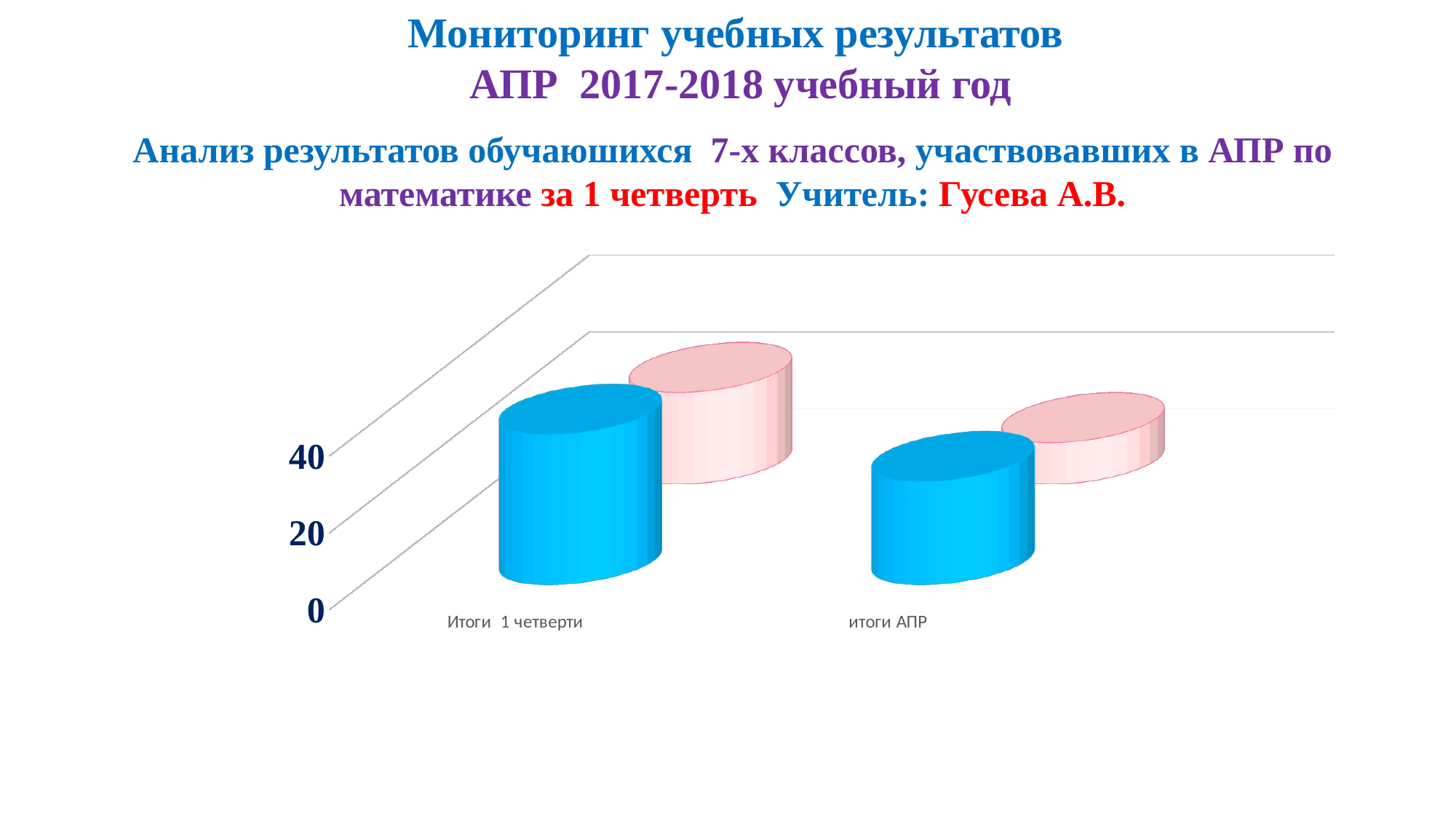
Do the values rise or fall from Итоги 1 четверти to итоги АПР? fall What two colours are used for the bars in the chart? blue and pink What are the two category labels on the x axis of the chart? Итоги 1 четверти, итоги АПР For the blue series, which category has the highest value? Итоги 1 четверти Is the blue bar for итоги АПР greater or less than 20? greater Which category has the taller pink bar, Итоги 1 четверти or итоги АПР? Итоги 1 четверти How many bars are plotted for each category in the chart? 2 Which category has the taller blue bar, Итоги 1 четверти or итоги АПР? Итоги 1 четверти For the blue series, which category has the lowest value? итоги АПР Is the blue bar for Итоги 1 четверти greater or less than 20? greater What kind of chart is shown on the slide? bar chart How many categories are shown on the x axis of the chart? 2